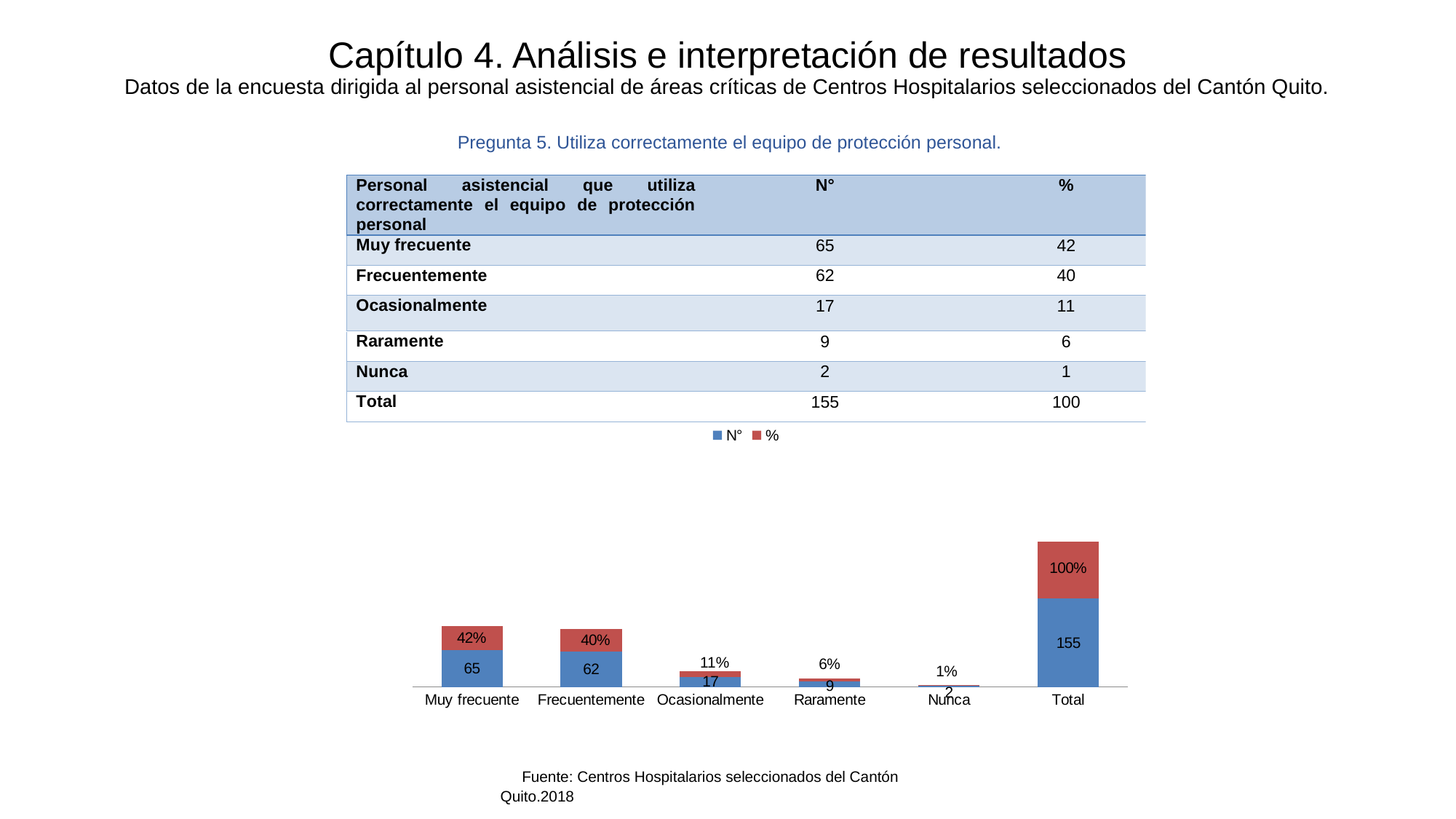
What is the N° value for Ocasionalmente in the chart? 17 What is the difference between the N° values for Muy frecuente and Frecuentemente? 3 What kind of chart is shown on the slide? bar chart Excluding the Total bar, which category has the highest N° value? Muy frecuente How many series does the chart legend list? 2 What is the % value for Raramente in the chart? 6% What is the % value for Frecuentemente in the chart? 40% Which series is shown in red in the chart? % What is the N° value for Nunca in the chart? 2 Excluding the Total bar, which category has the lowest N° value? Nunca What is the N° value for Muy frecuente in the chart? 65 How many categories are shown on the x axis of the chart? 6